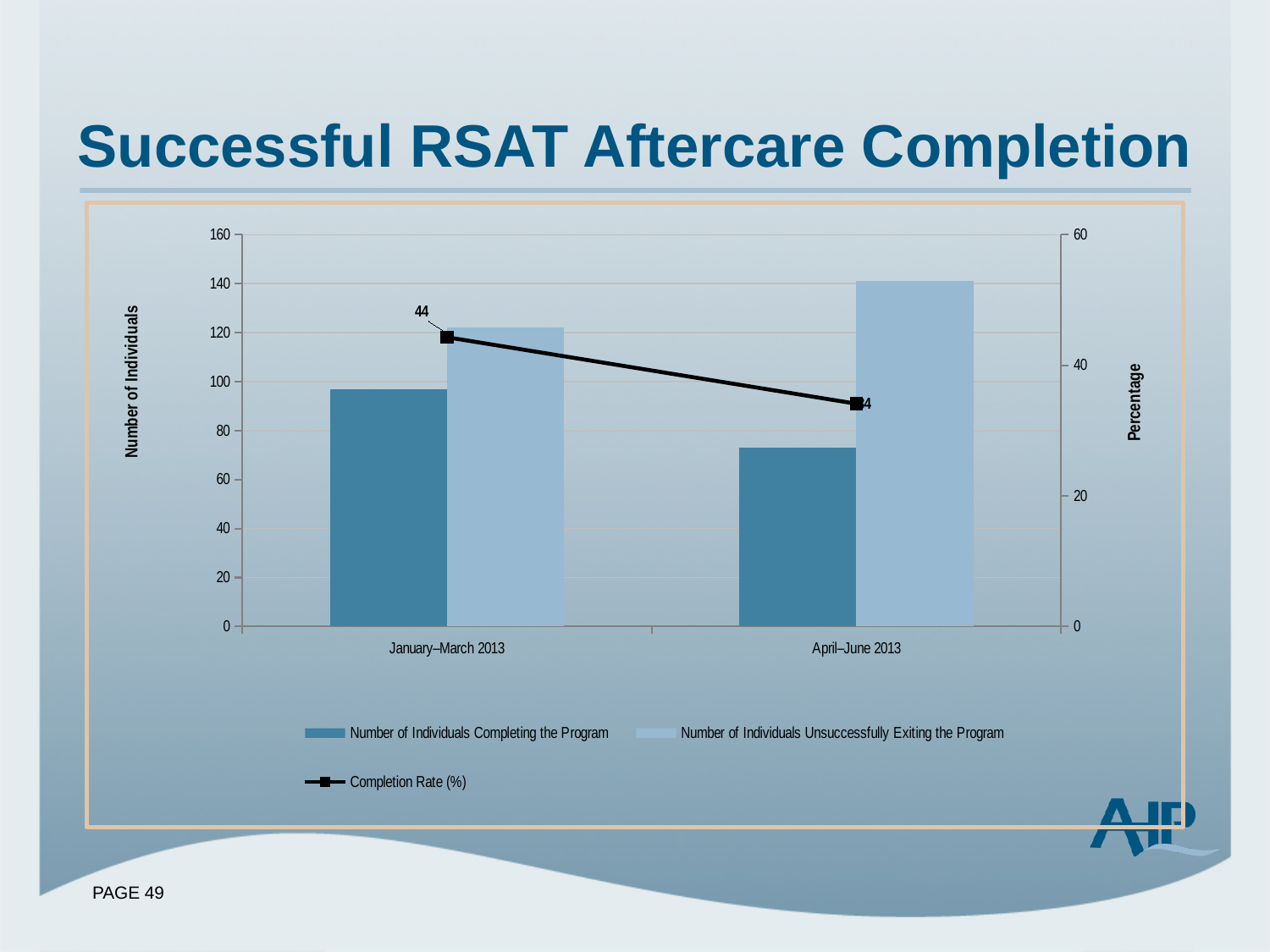
What kind of chart is shown on the slide? bar chart with a line Is the Number of Individuals Unsuccessfully Exiting the Program for April–June 2013 greater or less than 120? greater What is the title of the left vertical axis? Number of Individuals Which period has the highest Number of Individuals Unsuccessfully Exiting the Program? April–June 2013 Does the Completion Rate (%) rise or fall from January–March 2013 to April–June 2013? fall What is the Completion Rate (%) for January–March 2013? 44 Is the Number of Individuals Completing the Program for April–June 2013 greater or less than 80? less Is the Number of Individuals Completing the Program for January–March 2013 greater or less than 80? greater Which period has the larger Number of Individuals Completing the Program, January–March 2013 or April–June 2013? January–March 2013 How many time periods are shown on the x axis? 2 What is the title of the slide? Successful RSAT Aftercare Completion How many series does the legend list? 3